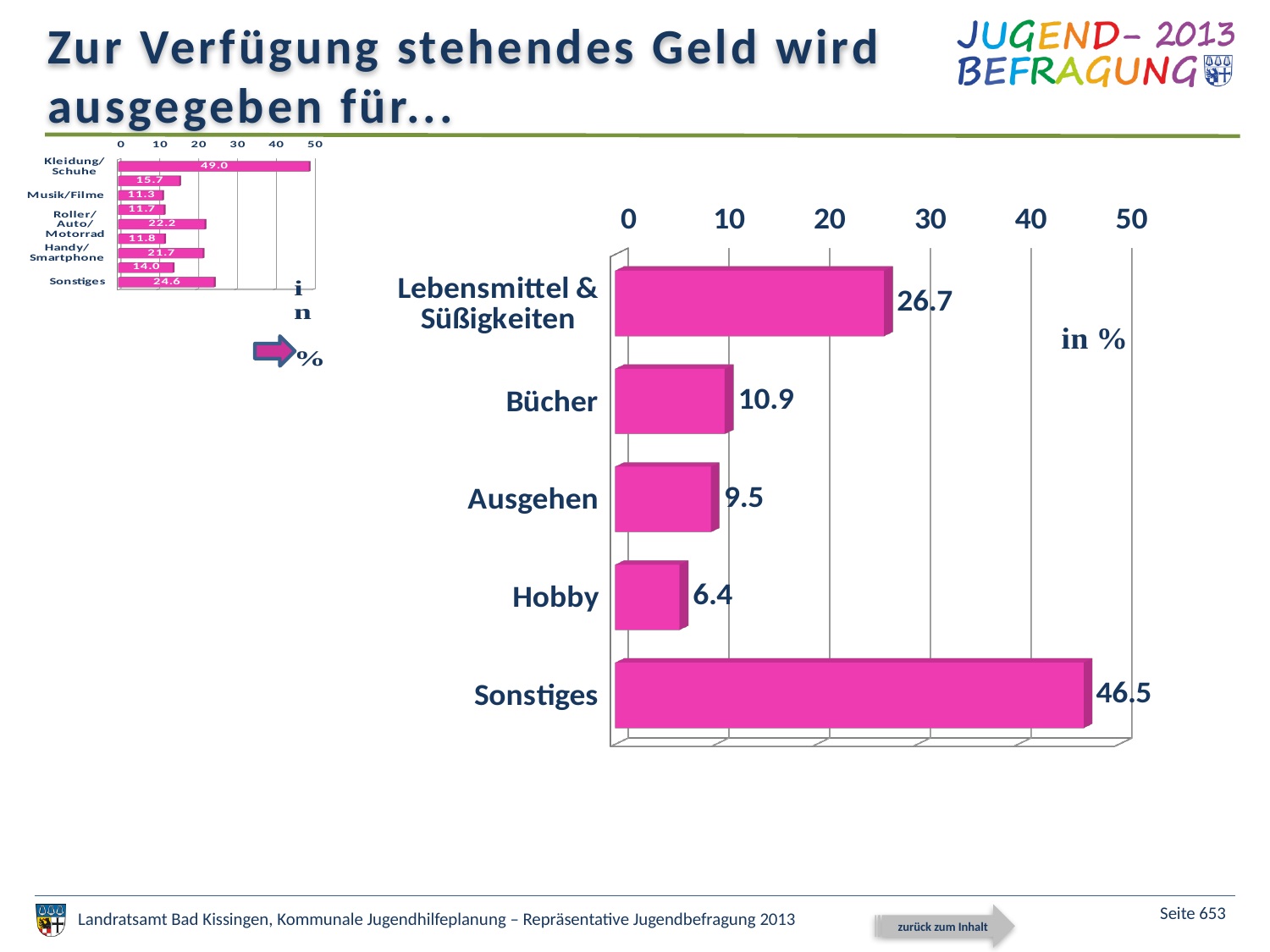
In the small chart at the top left, which category has the highest value? Kleidung/Schuhe In the large chart on the right, how many categories are shown? 5 In the large chart on the right, what is the difference between the values for Sonstiges and Lebensmittel & Süßigkeiten? 19.8 In the large chart on the right, which category has the highest value? Sonstiges In the large chart on the right, which category has the lowest value? Hobby In the large chart on the right, what is the difference between the values for Bücher and Ausgehen? 1.4 In the small chart at the top left, what is the value for Kleidung/Schuhe? 49.0 What kind of chart is the large chart on the right? Bar chart In the large chart on the right, what is the value for Hobby? 6.4 In the large chart on the right, which is larger, the value for Ausgehen or the value for Hobby? Ausgehen In the large chart on the right, what is the value for Lebensmittel & Süßigkeiten? 26.7 In the large chart on the right, what is the value for Bücher? 10.9